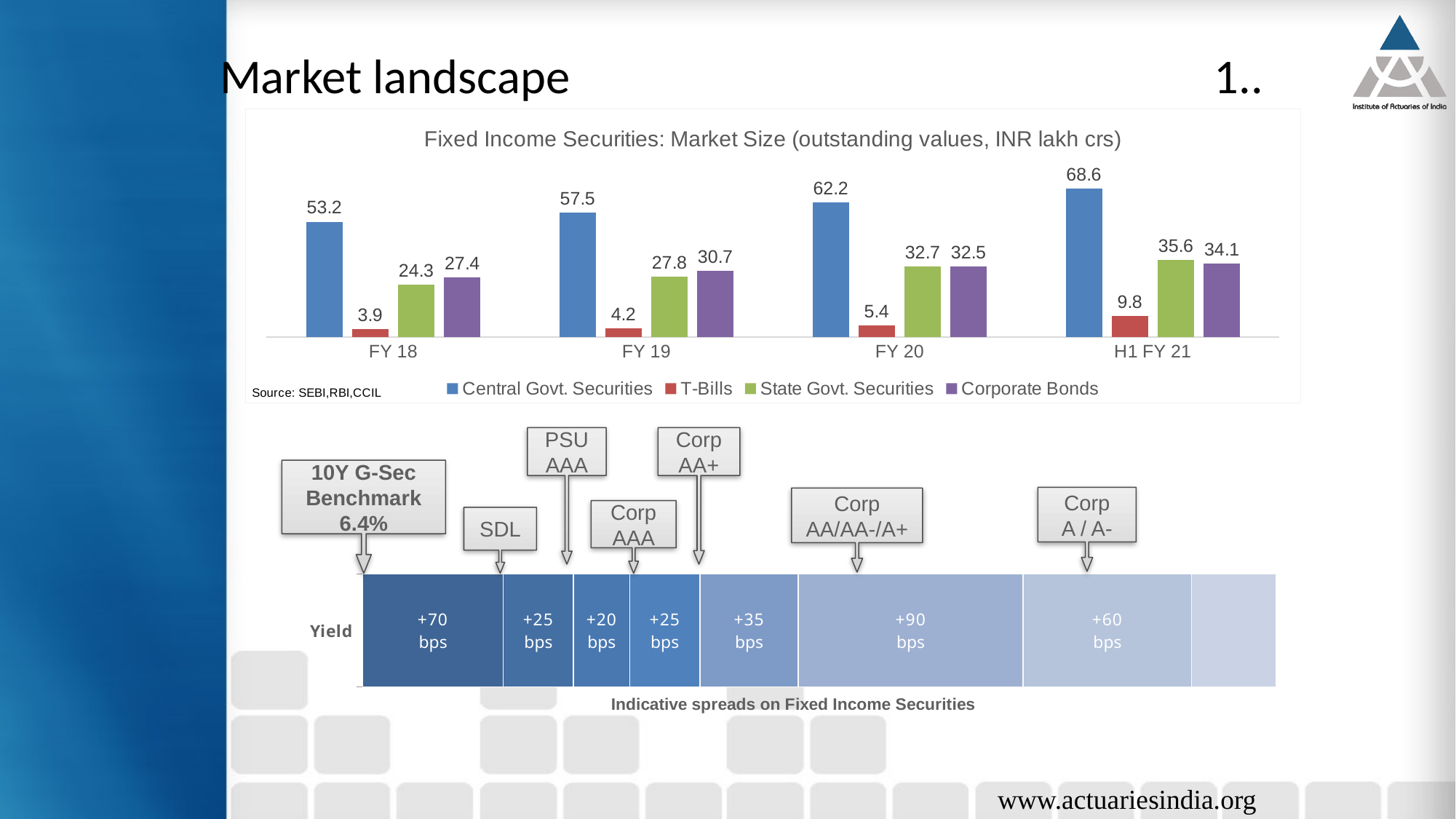
Which is larger in FY 19: State Govt. Securities or Corporate Bonds? Corporate Bonds What is the value for Corporate Bonds in FY 19? 30.7 What is the value for T-Bills in H1 FY 21? 9.8 In which period is the value for Central Govt. Securities highest? H1 FY 21 What is the difference between Central Govt. Securities in H1 FY 21 and FY 18? 15.4 How many series does the chart legend list? 4 What is the value for Central Govt. Securities in FY 20? 62.2 In which period is the value for T-Bills lowest? FY 18 What is the value for State Govt. Securities in FY 18? 24.3 How many periods are shown on the x axis of the chart? 4 What kind of chart is used to show Fixed Income Securities market size? Bar chart Do the values for Central Govt. Securities rise or fall from FY 18 to H1 FY 21? Rise